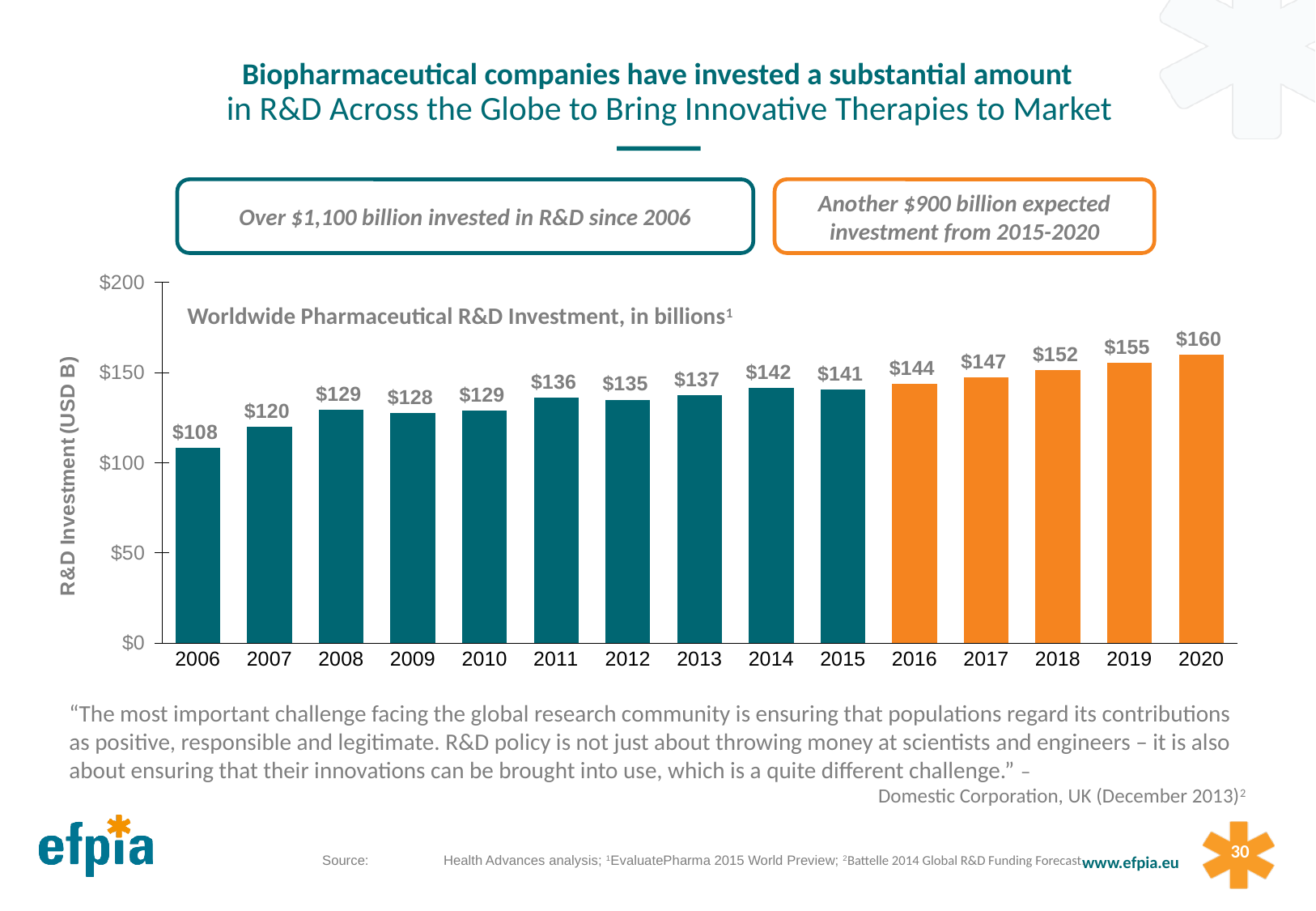
Which year has the highest R&D investment value? 2020 What is the R&D investment value shown for 2014? $142 Is the value for 2015 greater or less than $100? greater How many years are shown on the x axis of the chart? 15 Which year has a larger R&D investment value, 2011 or 2012? 2011 What is the difference between the R&D investment values for 2020 and 2006? $52 Do the R&D investment values generally rise or fall from 2006 to 2020? rise What is the label of the y axis of the chart? R&D Investment (USD B) What is the R&D investment value shown for 2020? $160 Which year has the lowest R&D investment value? 2006 What is the R&D investment value shown for 2006? $108 What kind of chart is used to show Worldwide Pharmaceutical R&D Investment? bar chart